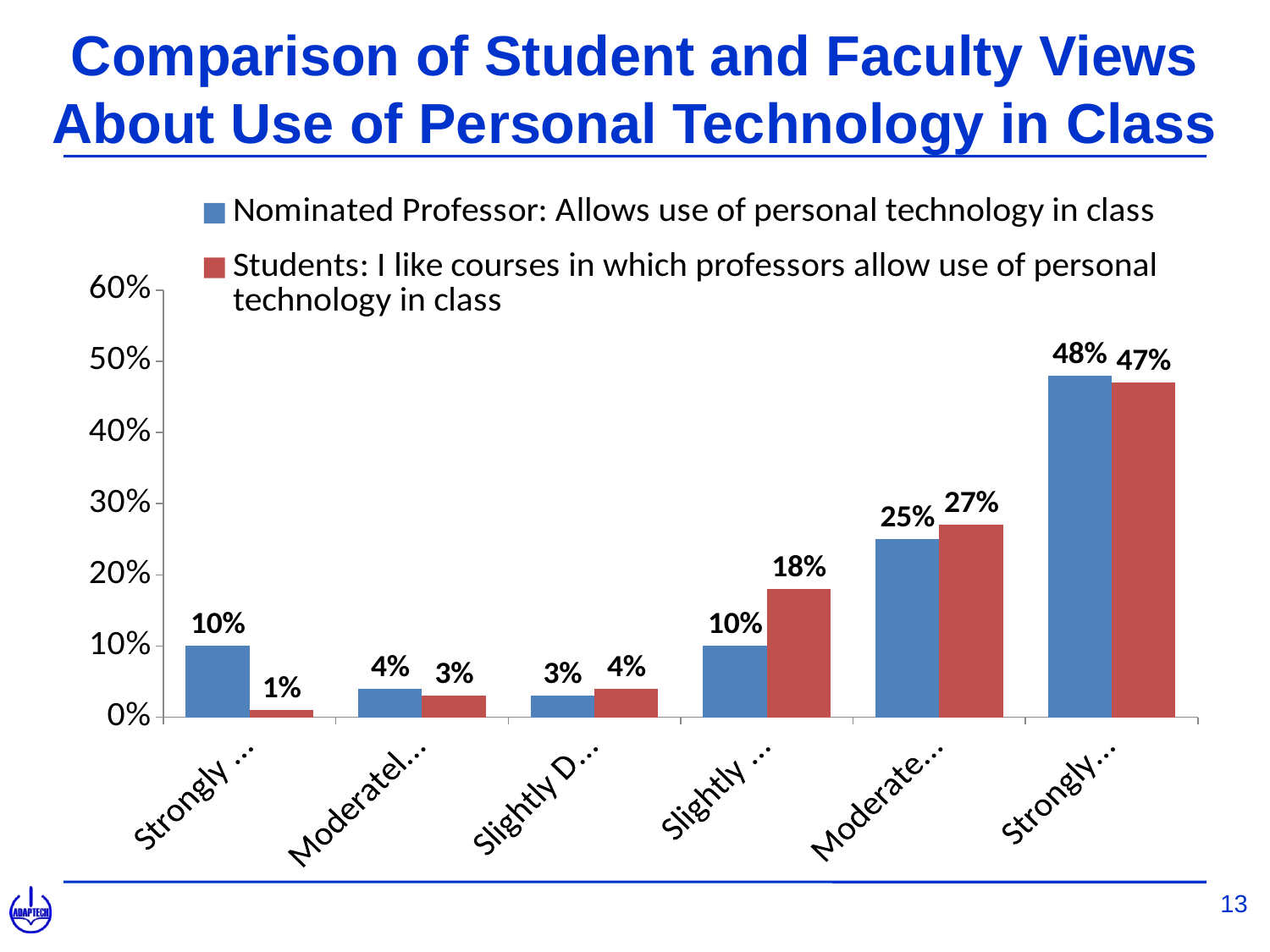
Which category has the highest value for the Students series: the leftmost or the rightmost? the rightmost What is the difference between the Students value and the Nominated Professor value for the fourth category from the left? 8% What is the value of the Nominated Professor series for the leftmost category? 10% What is the value of the Students series for the leftmost category? 1% For the fifth category from the left, which series has the larger value? Students What type of chart is shown on the slide? bar chart How many categories are shown on the x axis? 6 What is the value of the Students series for the fourth category from the left? 18% What is the value of the Nominated Professor series for the rightmost category? 48% What is the lowest value shown for the Students series? 1% What is the highest value shown for the Nominated Professor series? 48% How many series does the legend list? 2